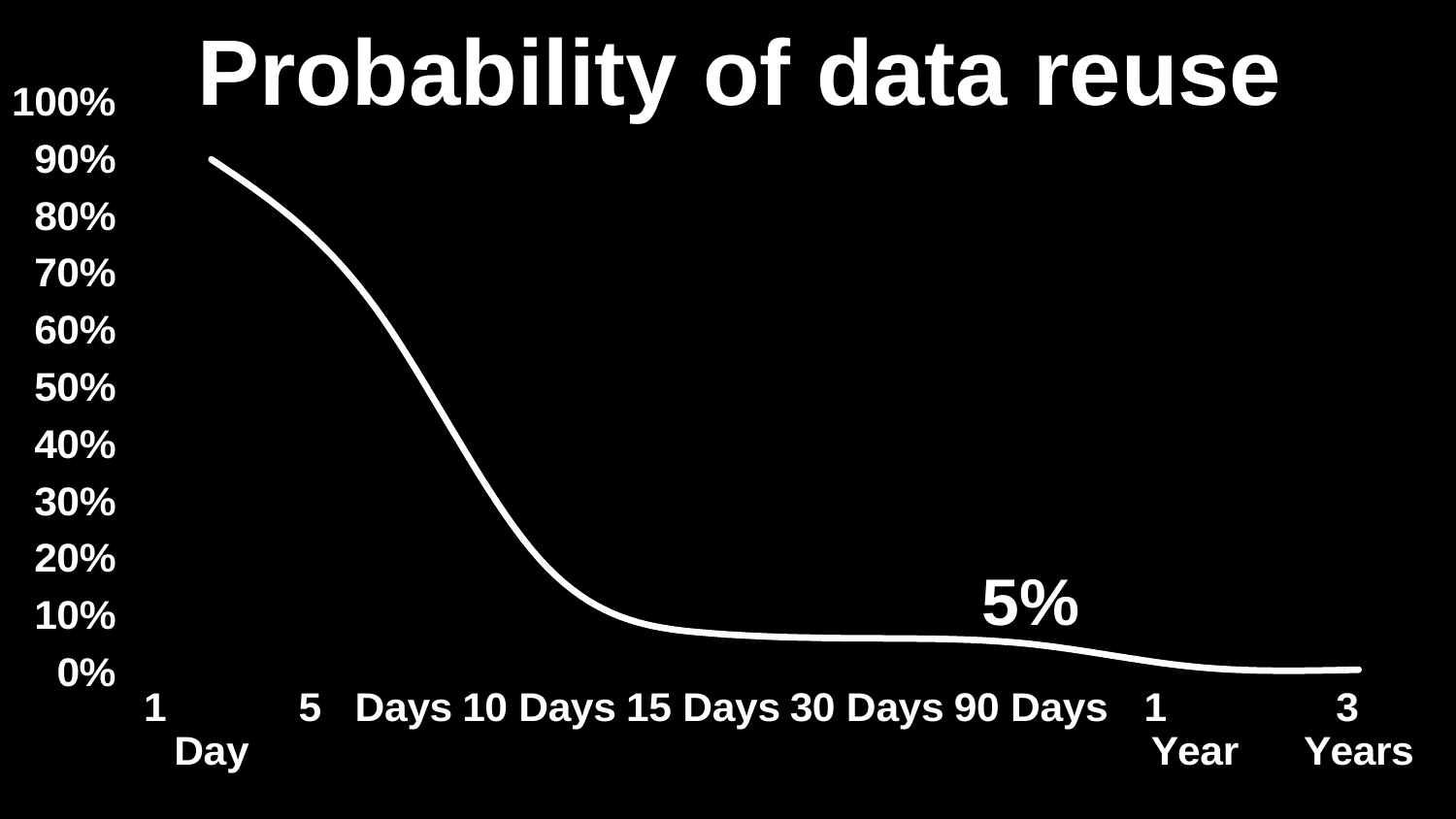
Is the value for 1 Day greater or less than 80%? greater What percentage value is printed as a label on the chart near 90 Days? 5% Which category has the highest probability of data reuse? 1 Day Which is larger, the value for 1 Day or the value for 1 Year? 1 Day Which category has the lowest probability of data reuse? 1 Year and 3 Years (tied at 1%) Is the value for 5 Days greater or less than 50%? greater Is the value for 15 Days greater or less than 20%? less Do the values rise or fall as you move along the x axis from 1 Day to 3 Years? fall What kind of chart is shown on the slide? line chart How many categories are shown on the x axis? 8 What is the title of the chart? Probability of data reuse